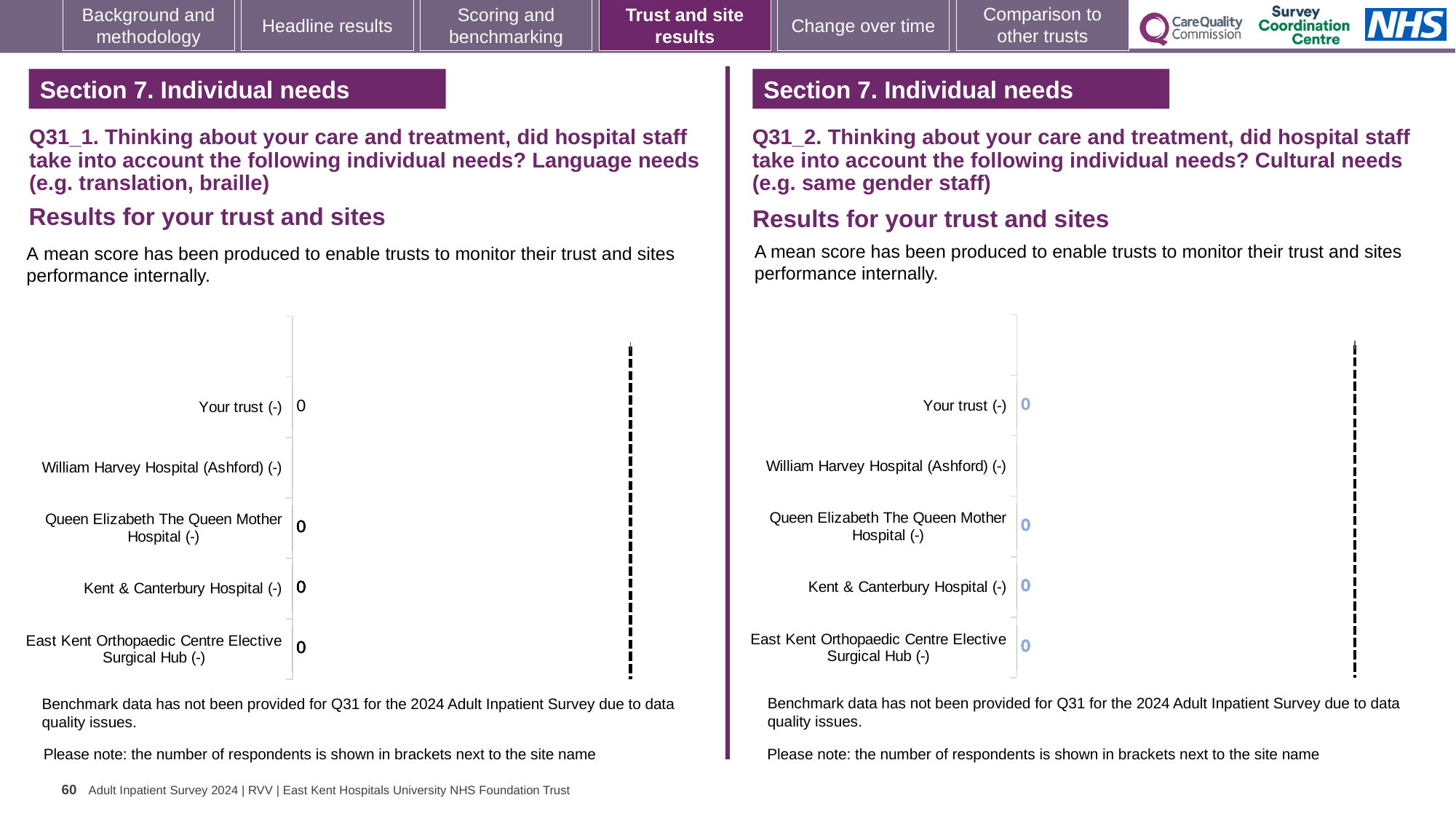
On the right chart (Q31_2, Cultural needs), what value is shown for Queen Elizabeth The Queen Mother Hospital (-)? 0 On the right chart (Q31_2, Cultural needs), what value is shown for Your trust (-)? 0 On the left chart (Q31_1, Language needs), what value is shown for Kent & Canterbury Hospital (-)? 0 On the left chart (Q31_1, Language needs), what value is shown for East Kent Orthopaedic Centre Elective Surgical Hub (-)? 0 On the left chart (Q31_1, Language needs), which category has no data label shown? William Harvey Hospital (Ashford) (-) On the right chart (Q31_2, Cultural needs), what value is shown for East Kent Orthopaedic Centre Elective Surgical Hub (-)? 0 How many categories are listed on the right chart (Q31_2, Cultural needs)? 5 On the right chart (Q31_2, Cultural needs), which category has no data label shown? William Harvey Hospital (Ashford) (-) What kind of chart is the left chart (Q31_1, Language needs)? Bar chart How many categories are listed on the left chart (Q31_1, Language needs)? 5 On the left chart (Q31_1, Language needs), what value is shown for Your trust (-)? 0 On the left chart (Q31_1, Language needs), what is the difference between the values for Your trust (-) and Kent & Canterbury Hospital (-)? 0